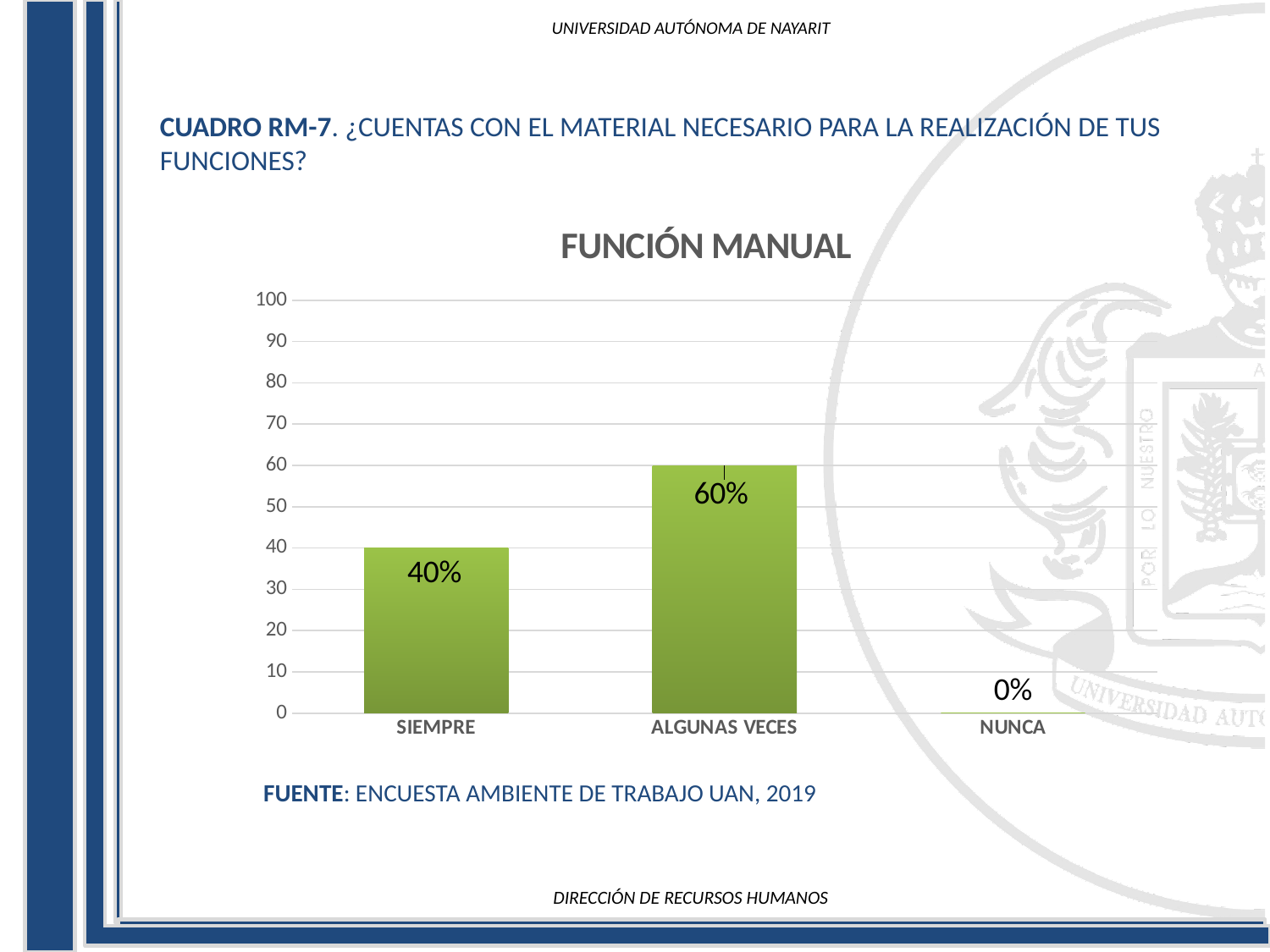
Which is larger, the value for SIEMPRE or the value for ALGUNAS VECES? ALGUNAS VECES Which category has the highest value? ALGUNAS VECES What is the maximum value shown on the y axis? 100 How many categories are shown on the x axis? 3 What is the difference between the values for ALGUNAS VECES and SIEMPRE? 20% What is the value for SIEMPRE? 40% What is the value for NUNCA? 0% Which category has the lowest value? NUNCA What is the value for ALGUNAS VECES? 60% Is the value for ALGUNAS VECES greater or less than 50? greater What is the title of the chart? FUNCIÓN MANUAL What kind of chart is shown? bar chart